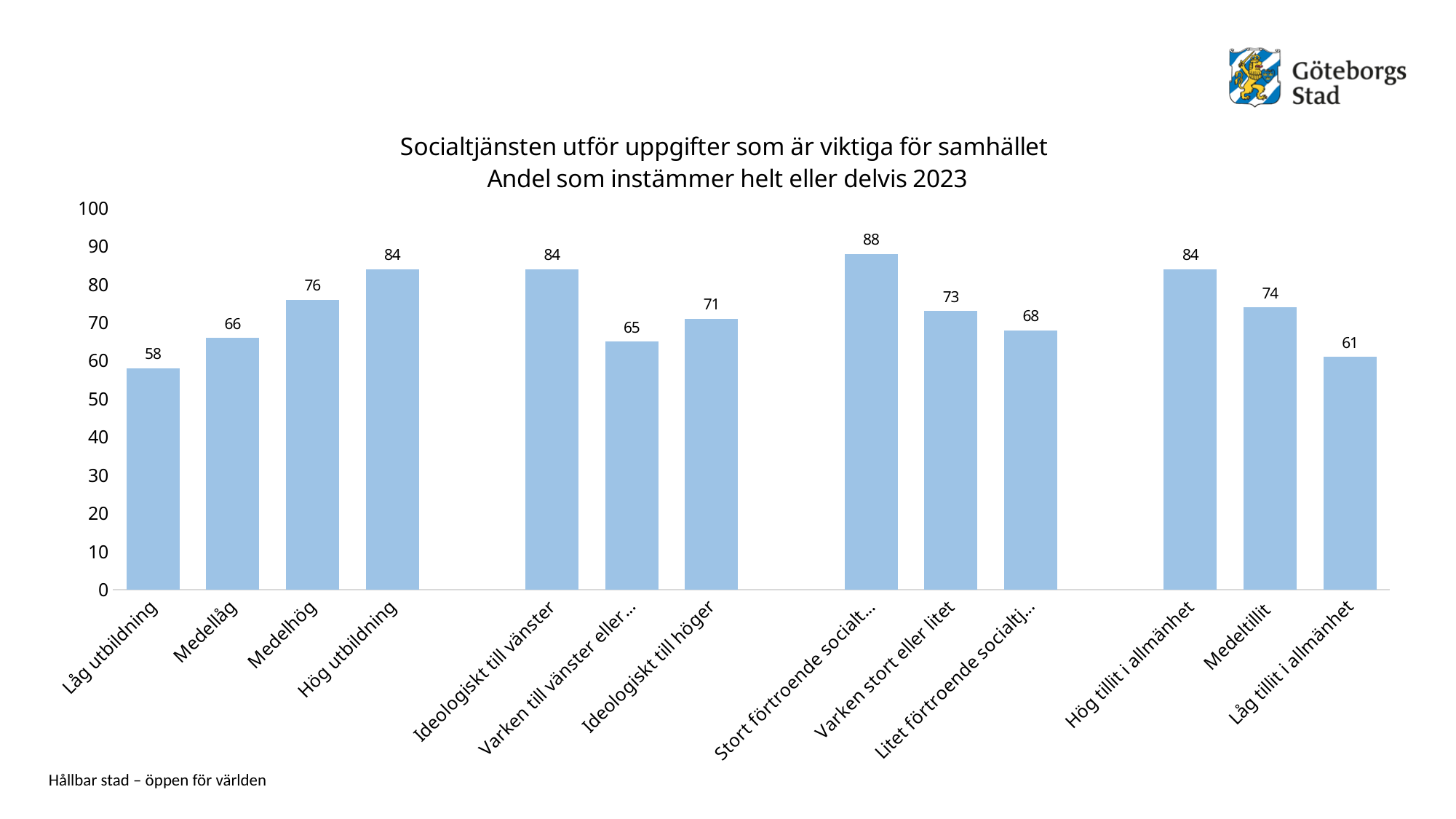
What is the value for Låg utbildning? 58 Which is larger, Varken stort eller litet or Medeltillit? Medeltillit What is the value for Medeltillit? 74 What is the highest value shown on the chart? 88 What is the value for Ideologiskt till höger? 71 What is the difference between Hög utbildning and Låg utbildning? 26 What is the first line of the chart title? Socialtjänsten utför uppgifter som är viktiga för samhället What is the value for Medelhög? 76 What kind of chart is this? Bar chart How many bars are shown on the chart? 13 Which category has the lowest value? Låg utbildning What is the value for Låg tillit i allmänhet? 61